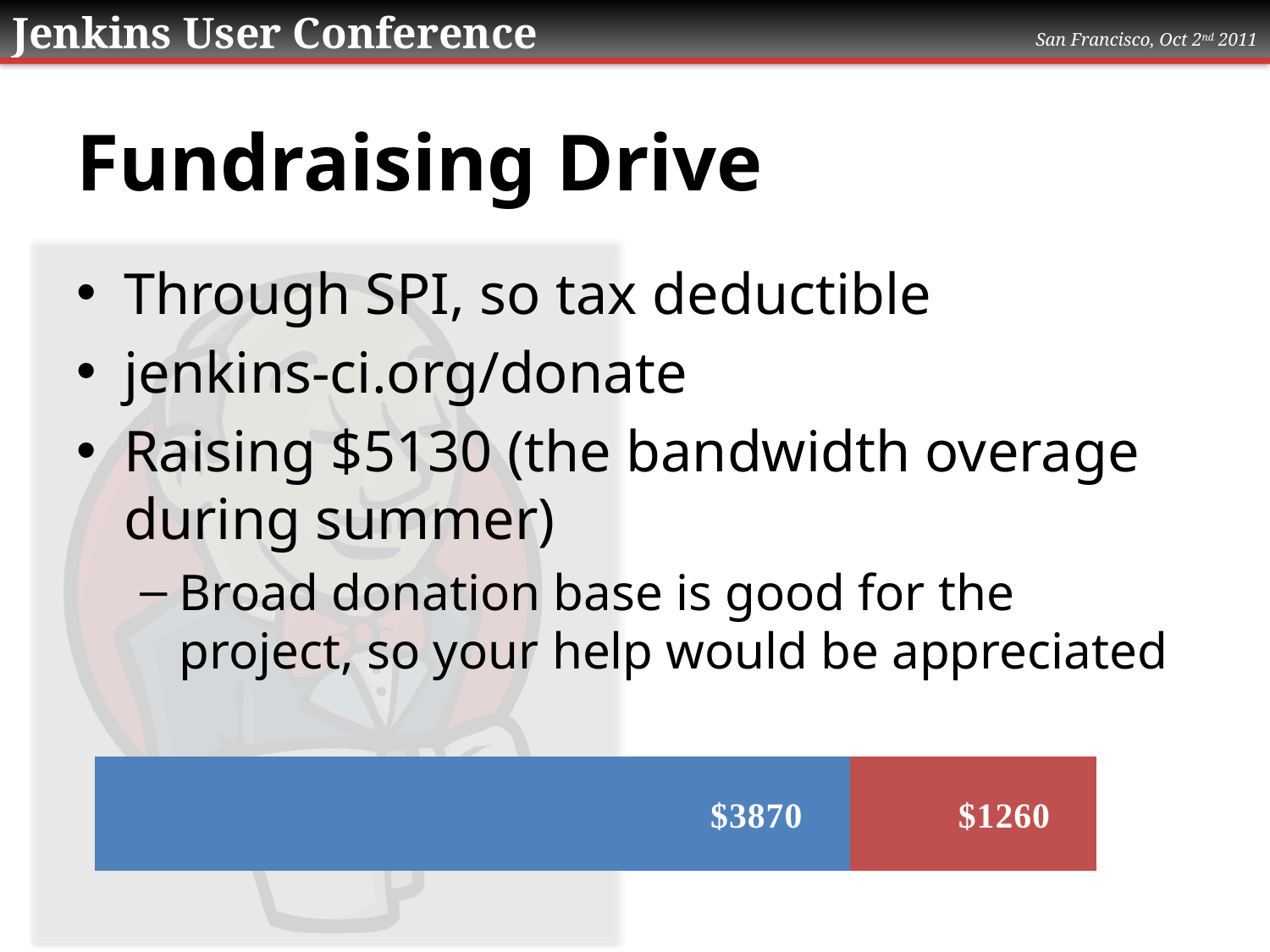
Which segment of the bar has the largest value? the blue segment ($3870) What colour is the segment labelled $1260? red Is the bar on the slide oriented horizontally or vertically? horizontally What value is printed on the blue segment of the bar? $3870 How many segments does the stacked bar contain? 2 Which segment of the bar has the larger value, the blue one or the red one? the blue one What kind of chart is shown at the bottom of the slide? a stacked bar chart What value is printed on the red segment of the bar? $1260 What is the difference between the blue segment's value and the red segment's value? $2610 Which segment of the bar has the smallest value? the red segment ($1260) What is the total of the two segments in the stacked bar? $5130